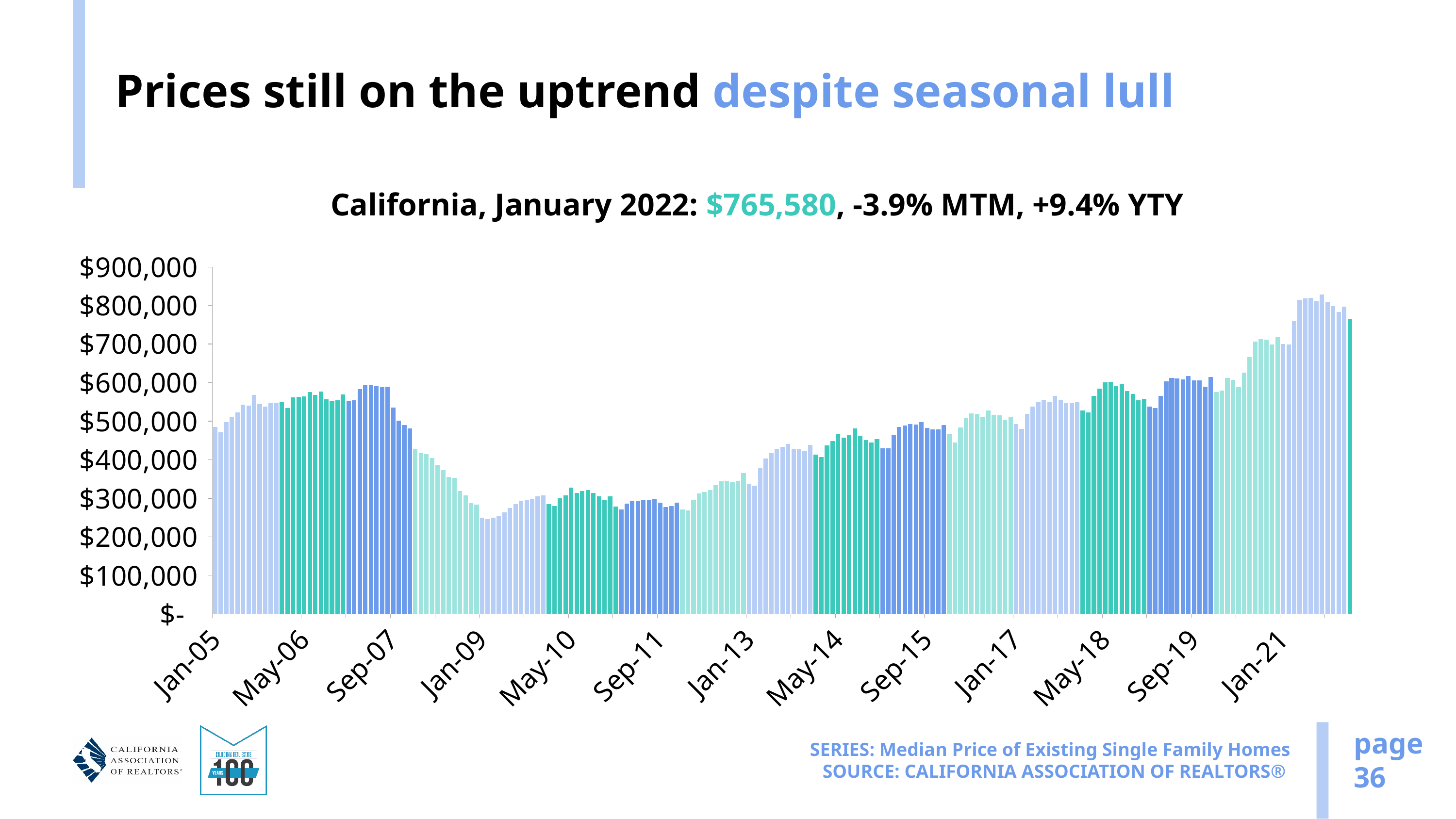
Is the value for Jan-05 greater or less than $400,000? greater What is the median price for California in January 2022 shown on the chart? $765,580 What kind of chart is shown on the slide? bar chart Is the value for May-18 greater or less than $500,000? greater Do the values generally rise or fall from Jan-09 to Jan-21? rise What is the month-to-month (MTM) change stated in the chart title? -3.9% Which is larger, the value for Jan-21 or the value for Jan-05? Jan-21 What is the year-to-year (YTY) change stated in the chart title? +9.4% Is the value for Jan-09 greater or less than $300,000? less Which is larger, the value for Sep-07 or the value for Sep-11? Sep-07